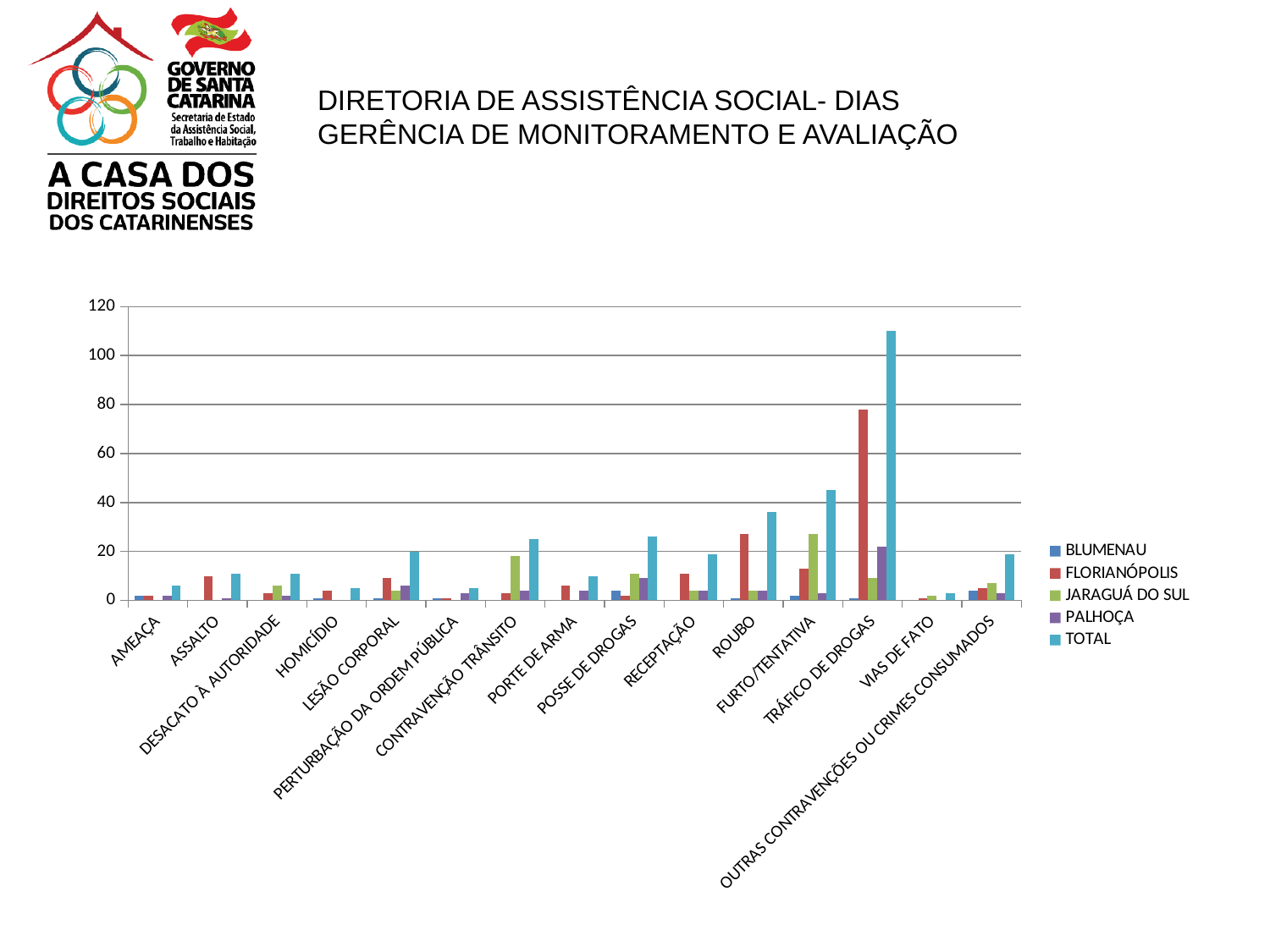
Which is larger for FURTO/TENTATIVA: the FLORIANÓPOLIS value or the JARAGUÁ DO SUL value? JARAGUÁ DO SUL Is the TOTAL value for ROUBO greater or less than 40? less Which series is shown in red in the legend? FLORIANÓPOLIS How many categories are shown along the x axis? 15 For which category is the TOTAL value highest? TRÁFICO DE DROGAS What kind of chart is shown on the slide? bar chart Is the TOTAL value for TRÁFICO DE DROGAS greater or less than 100? greater Is the FLORIANÓPOLIS value for TRÁFICO DE DROGAS greater or less than 60? greater Which series is listed last in the legend? TOTAL Which is larger for TRÁFICO DE DROGAS: the FLORIANÓPOLIS value or the PALHOÇA value? FLORIANÓPOLIS How many series does the legend list? 5